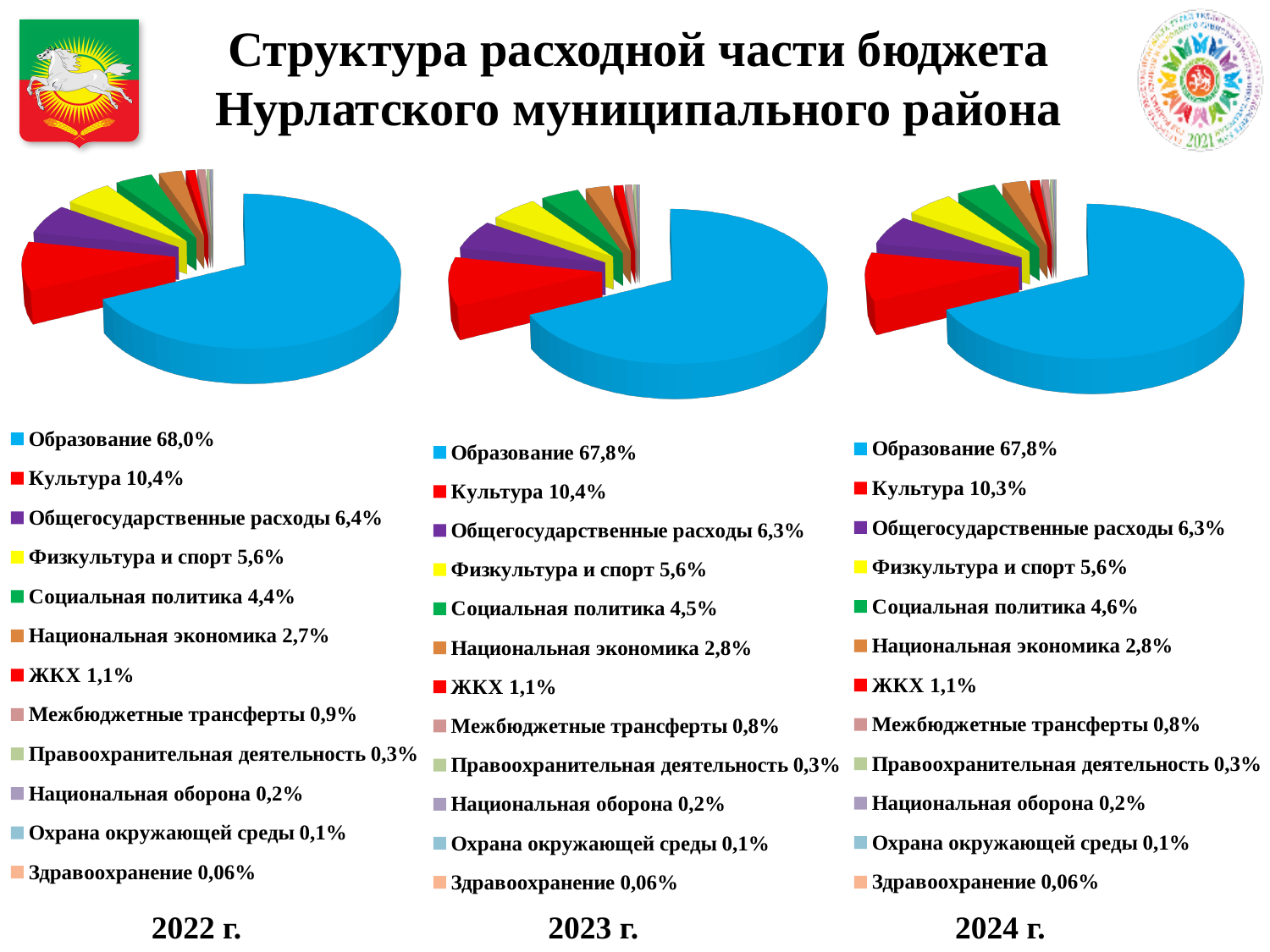
In the 2024 г. chart, what is the value for Национальная экономика? 2,8% How many pie charts are shown on the slide? 3 In the 2022 г. chart, which category has the smallest share? Здравоохранение In the 2022 г. chart, which is larger: Общегосударственные расходы or Физкультура и спорт? Общегосударственные расходы In the 2024 г. chart, what is the value for Социальная политика? 4,6% In the 2023 г. chart, what is the difference between Образование and Культура? 57,4% In the 2024 г. chart, which category has the largest share? Образование What kind of chart is used for the 2022 г. budget structure? pie chart How many categories does the legend of the 2023 г. chart list? 12 In the 2022 г. chart, what share of expenditure is Образование? 68,0% In the 2022 г. chart, what is the value for Межбюджетные трансферты? 0,9% In the 2023 г. chart, what is the value for Культура? 10,4%